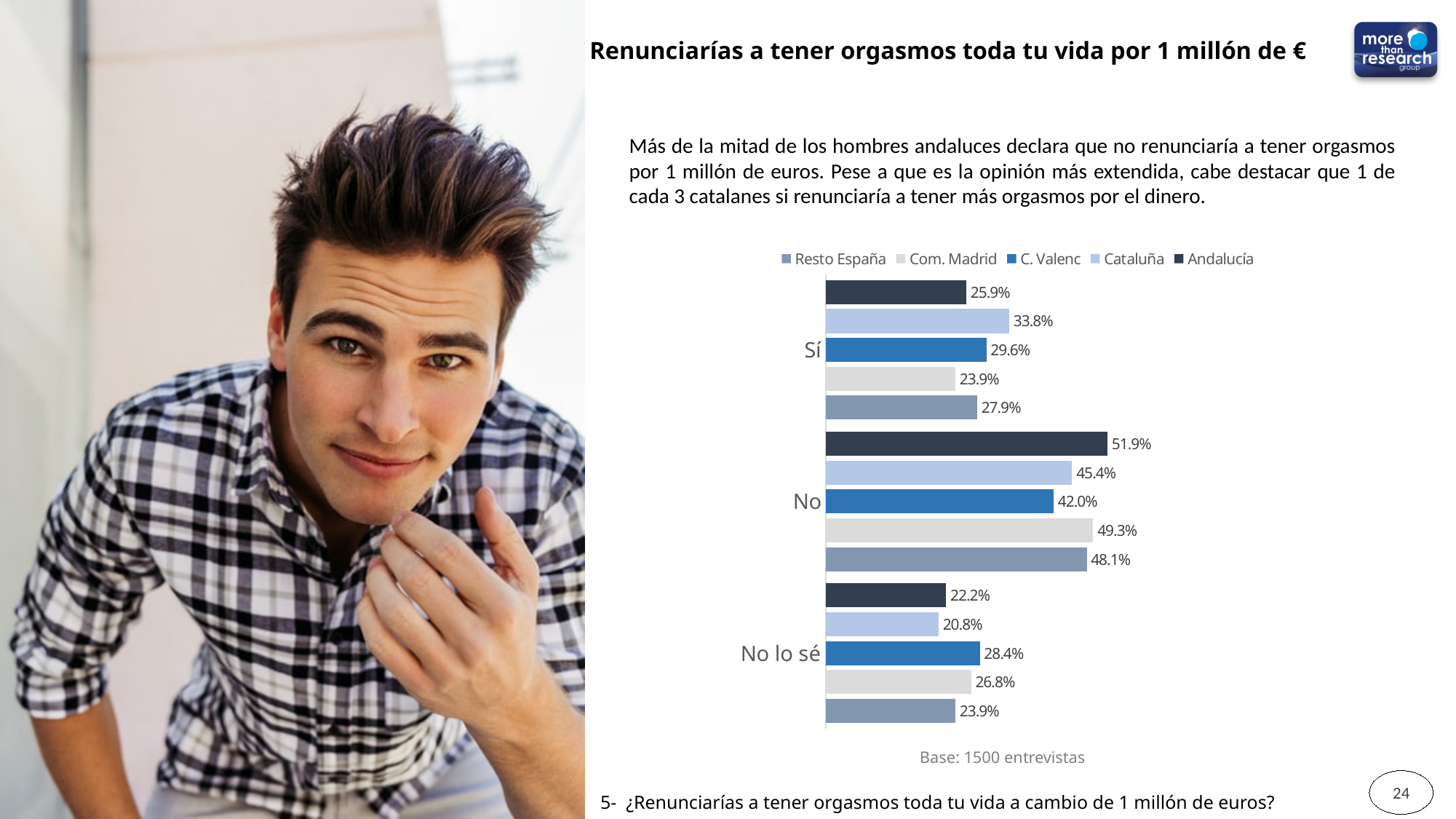
What is the value for C. Valenc in the "No lo sé" category? 28.4% What is the value for Cataluña in the "Sí" category? 33.8% Which region has the lowest value in the "No lo sé" category? Cataluña How many answer categories are shown on the chart? 3 What percentage of Andalucía respondents answered "No"? 51.9% How many series does the legend list? 5 Which region has the lowest value in the "No" category? C. Valenc What is the difference between Andalucía's "No" value and Cataluña's "No" value? 6.5% Which is larger: Resto España's "Sí" value or Com. Madrid's "Sí" value? Resto España Which region has the highest value in the "Sí" category? Cataluña What is the value for Com. Madrid in the "No" category? 49.3% What kind of chart is shown on the slide? Bar chart